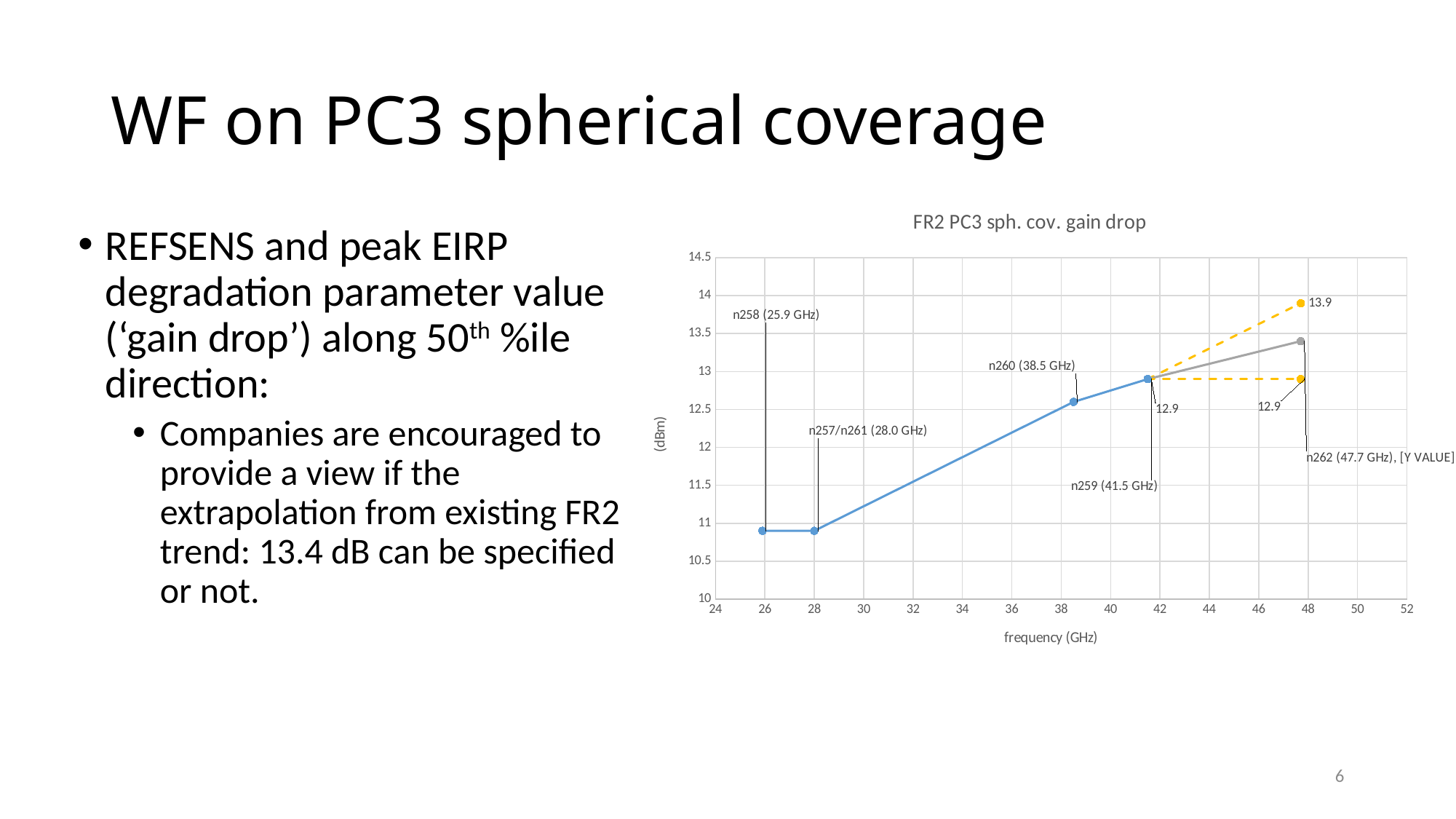
What is the label of the x axis of the chart? frequency (GHz) Do the values of the blue line rise or fall as frequency increases from 28 GHz to 41.5 GHz? rise What value is labelled for the upper yellow dashed point at 47.7 GHz? 13.9 Is the value for n260 (38.5 GHz) greater or less than 12? greater Is the value for n258 (25.9 GHz) greater or less than 12? less Which has the larger value, n260 (38.5 GHz) or n258 (25.9 GHz)? n260 (38.5 GHz) What kind of chart is shown on the slide? line chart What is the difference between the upper (13.9) and lower (12.9) yellow dashed points at 47.7 GHz? 1.0 At which frequency is the highest plotted value on the chart? 47.7 GHz What is the title of the chart? FR2 PC3 sph. cov. gain drop What value is labelled for the lower yellow dashed point at 47.7 GHz? 12.9 What value is labelled for n259 (41.5 GHz)? 12.9